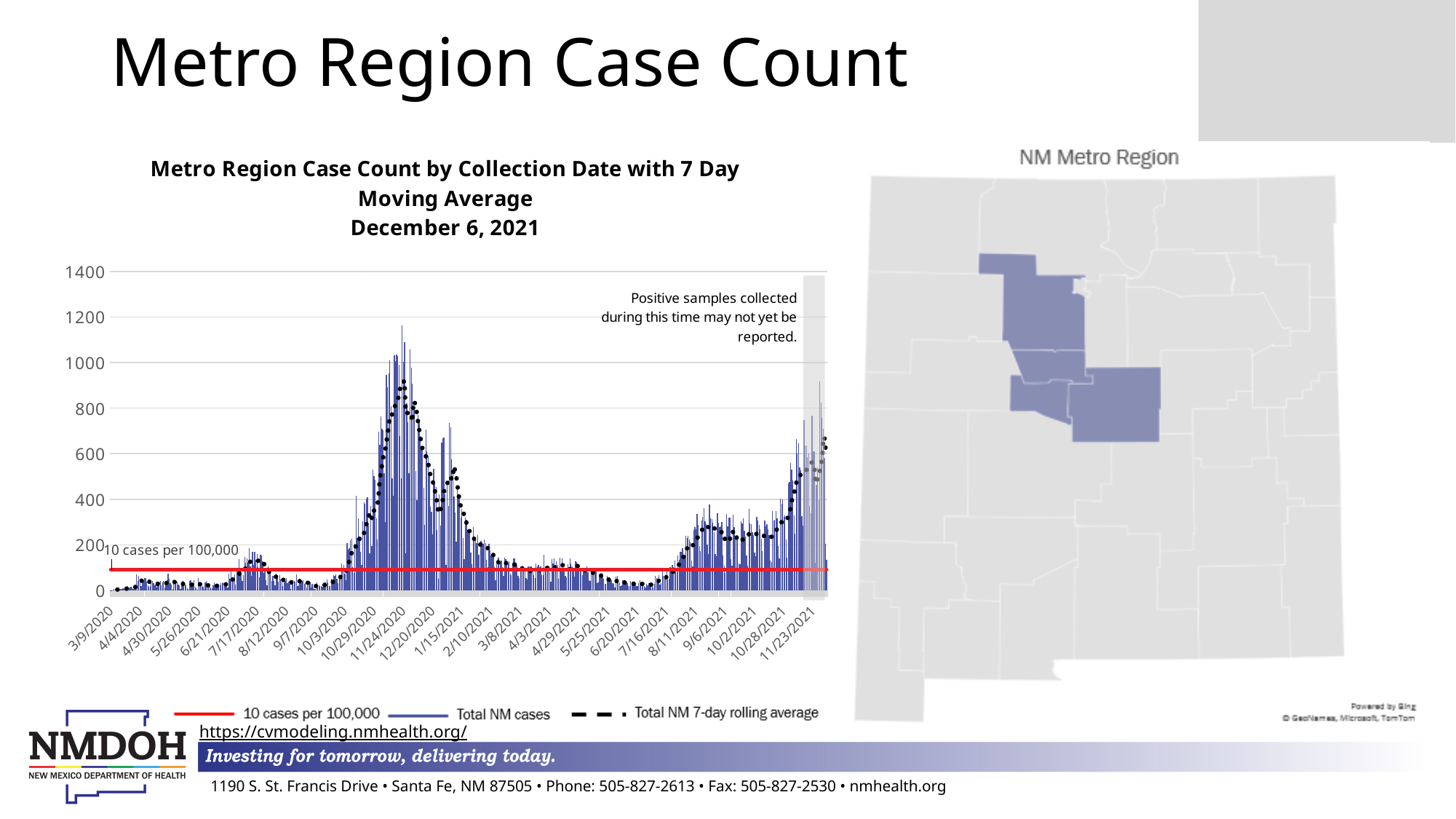
Do the case counts rise or fall between 11/24/2020 and 3/8/2021? fall Is the 7-day rolling average around 9/6/2021 greater or less than 200? greater What does the red horizontal line on the chart represent, according to the legend? 10 cases per 100,000 Is the daily case count around 3/8/2021 greater or less than 200? less Which peak is higher: the one in late November 2020 or the one in September 2021? late November 2020 Around which x-axis date label does the chart reach its highest daily case count? 11/24/2020 Is the highest daily case count near 11/24/2020 greater or less than 1000? greater How many series does the legend of the case count chart list? 3 What kind of chart is used to show the Metro Region case counts? bar chart Do the case counts rise or fall between 10/28/2021 and 11/23/2021? rise What is the title of the chart on the left of the slide? Metro Region Case Count by Collection Date with 7 Day Moving Average December 6, 2021